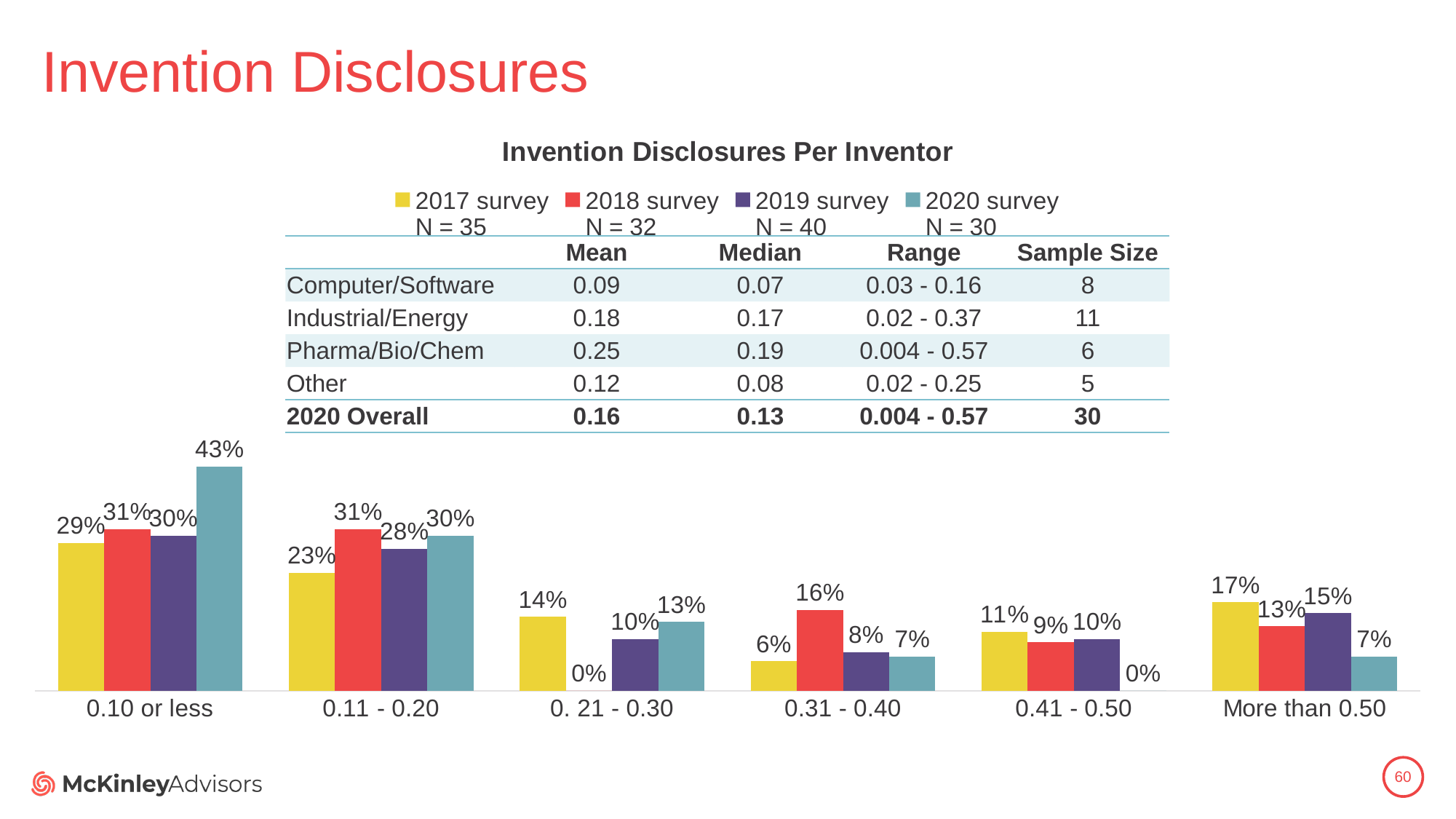
How many categories are shown along the x axis of the chart? 6 Which is larger in the '0.11 - 0.20' category: the 2017 survey value or the 2018 survey value? 2018 survey What is the sample size (N) for the 2019 survey shown in the legend? N = 40 What is the value for the 2020 survey in the '0.10 or less' category? 43% How many series does the chart legend list? 4 What is the title of the chart? Invention Disclosures Per Inventor Which category has the lowest value for the 2018 survey? 0. 21 - 0.30 What is the value for the 2018 survey in the '0.31 - 0.40' category? 16% What kind of chart is shown on the slide? bar chart What is the difference between the 2020 survey and 2017 survey values in the '0.10 or less' category? 14% Which category has the highest value for the 2020 survey? 0.10 or less What is the value for the 2017 survey in the 'More than 0.50' category? 17%